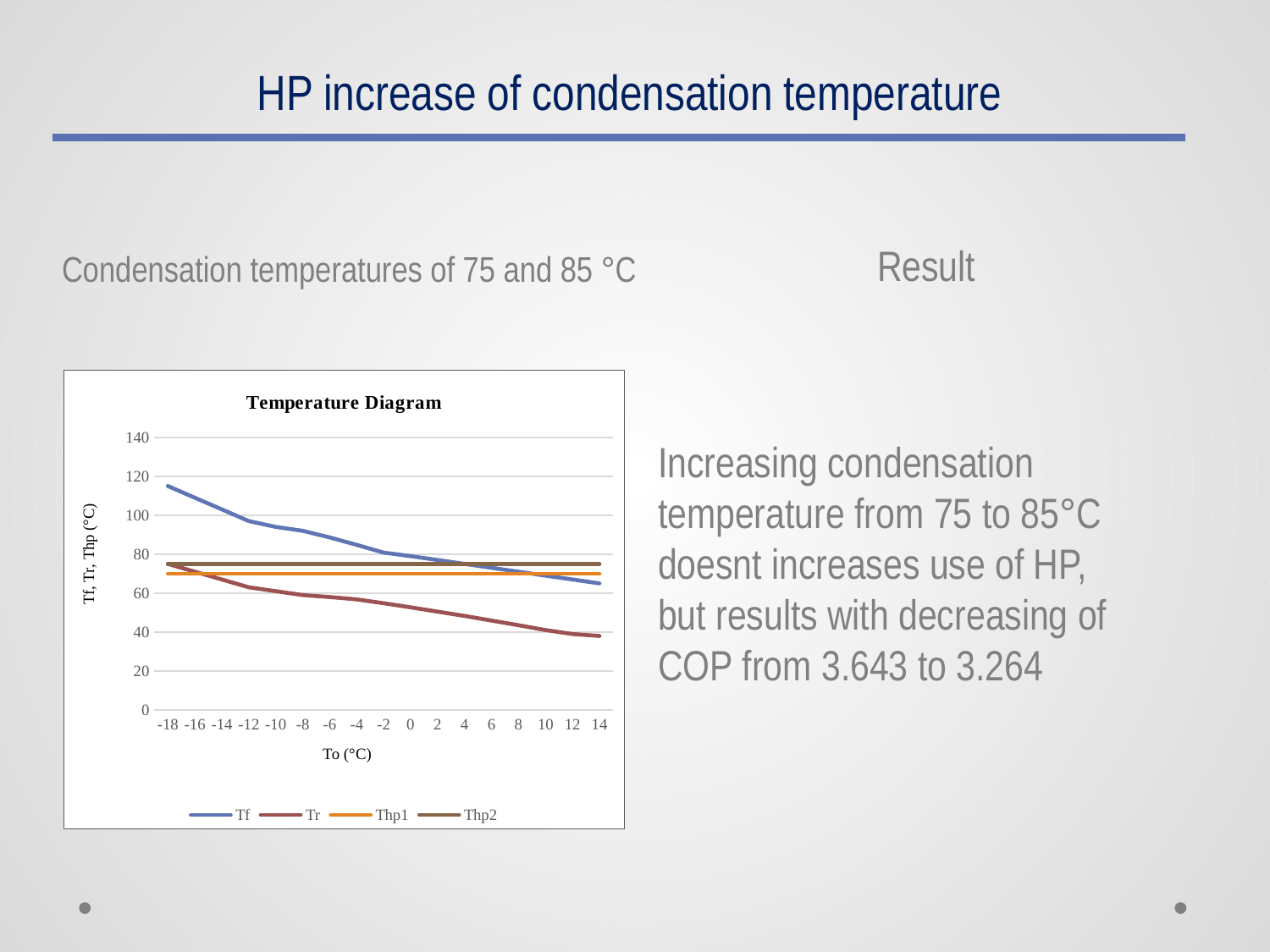
Which series has the lowest value at To = 14? Tr Is the value of Tf at To = -18 greater or less than 100? greater Is the value of Tr at To = 14 greater or less than 60? less How many series does the legend of the Temperature Diagram list? 4 Does the Tf series rise or fall as To (°C) increases from -18 to 14? fall What kind of chart is the Temperature Diagram? line chart How many To (°C) values are marked along the x axis of the Temperature Diagram? 17 What is the label of the x axis of the Temperature Diagram? To (°C) Which of the two flat series, Thp1 or Thp2, lies higher on the chart? Thp2 Does the Tr series rise or fall as To (°C) increases from -18 to 14? fall Is the value of Tf at To = 14 greater or less than 80? less Which series has the highest value at To = -18? Tf